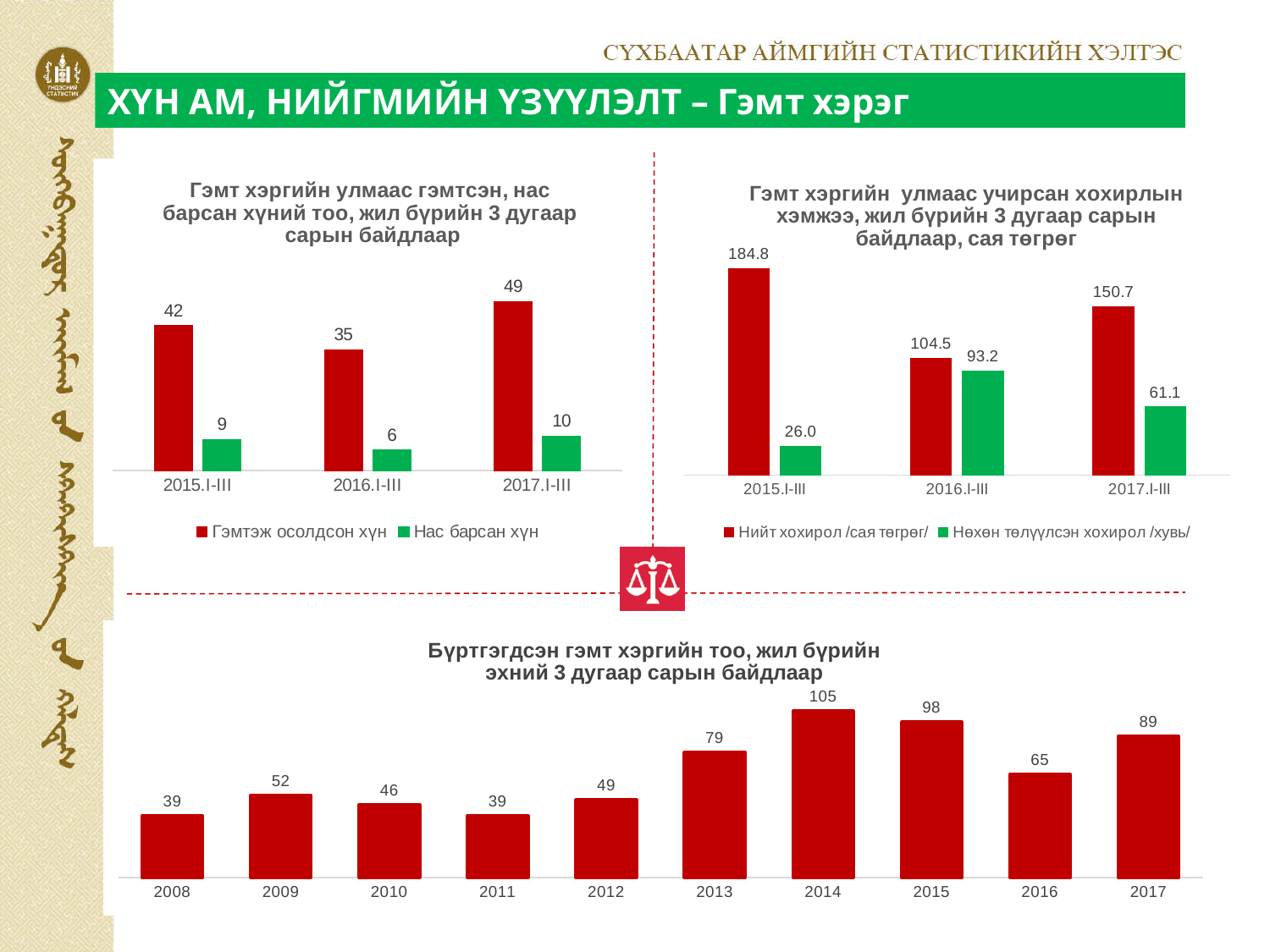
How many years are shown on the x axis of the bottom chart? 10 In the top-right chart, which is larger in 2017.I-III: Нийт хохирол /сая төгрөг/ or Нөхөн төлүүлсэн хохирол /хувь/? Нийт хохирол /сая төгрөг/ In the top-left chart, what is the value for Гэмтэж осолдсон хүн in 2017.I-III? 49 In the bottom chart, what is the value for 2016? 65 In the top-left chart, what is the value for Нас барсан хүн in 2016.I-III? 6 How many series does the legend of the top-left chart list? 2 In the top-right chart, what is the value for Нийт хохирол /сая төгрөг/ in 2015.I-III? 184.8 In the bottom chart, which year has the highest number of registered crimes? 2014 In the top-right chart, which period has the lowest value for Нийт хохирол /сая төгрөг/? 2016.I-III In the top-right chart, what is the value for Нөхөн төлүүлсэн хохирол /хувь/ in 2016.I-III? 93.2 In the top-left chart, what is the difference between Гэмтэж осолдсон хүн and Нас барсан хүн in 2015.I-III? 33 What kind of chart is the bottom chart? bar chart